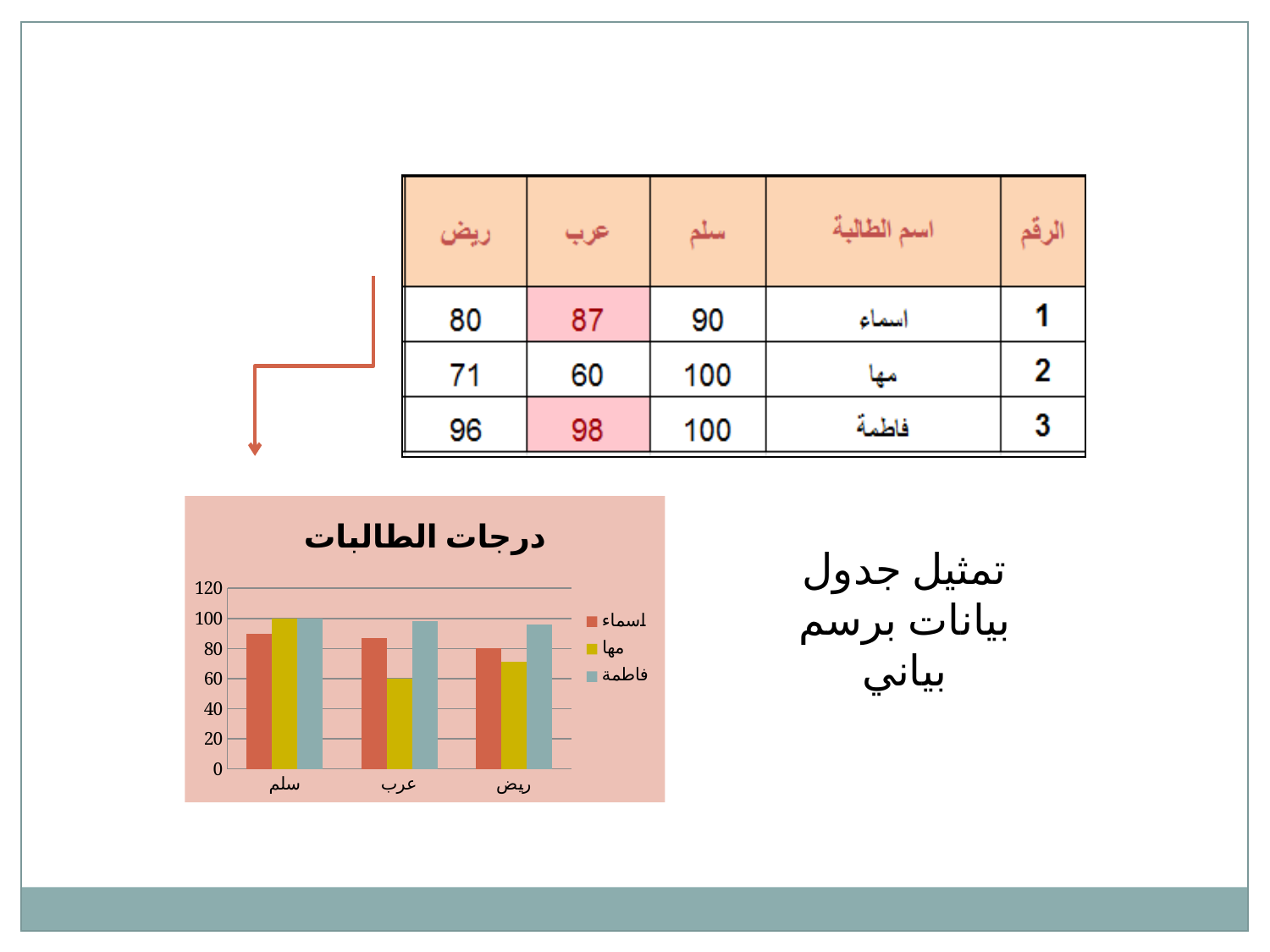
What is the value for مها in the سلم category? 100 What kind of chart is shown on the slide? bar chart Which student has the highest bar in the ريض category? فاطمة Which student has the lowest bar in the عرب category? مها What is the value for اسماء in the عرب category? 87 How many series does the chart legend list? 3 How many categories are shown on the x axis of the chart? 3 What is the difference between the values for فاطمة and مها in the عرب category? 38 What is the title of the chart? درجات الطالبات Do the bars for اسماء rise or fall moving from سلم to ريض along the x axis? fall Is the value for مها in the عرب category greater or less than 80? less In the ريض category, which is larger: the bar for اسماء or the bar for مها? اسماء